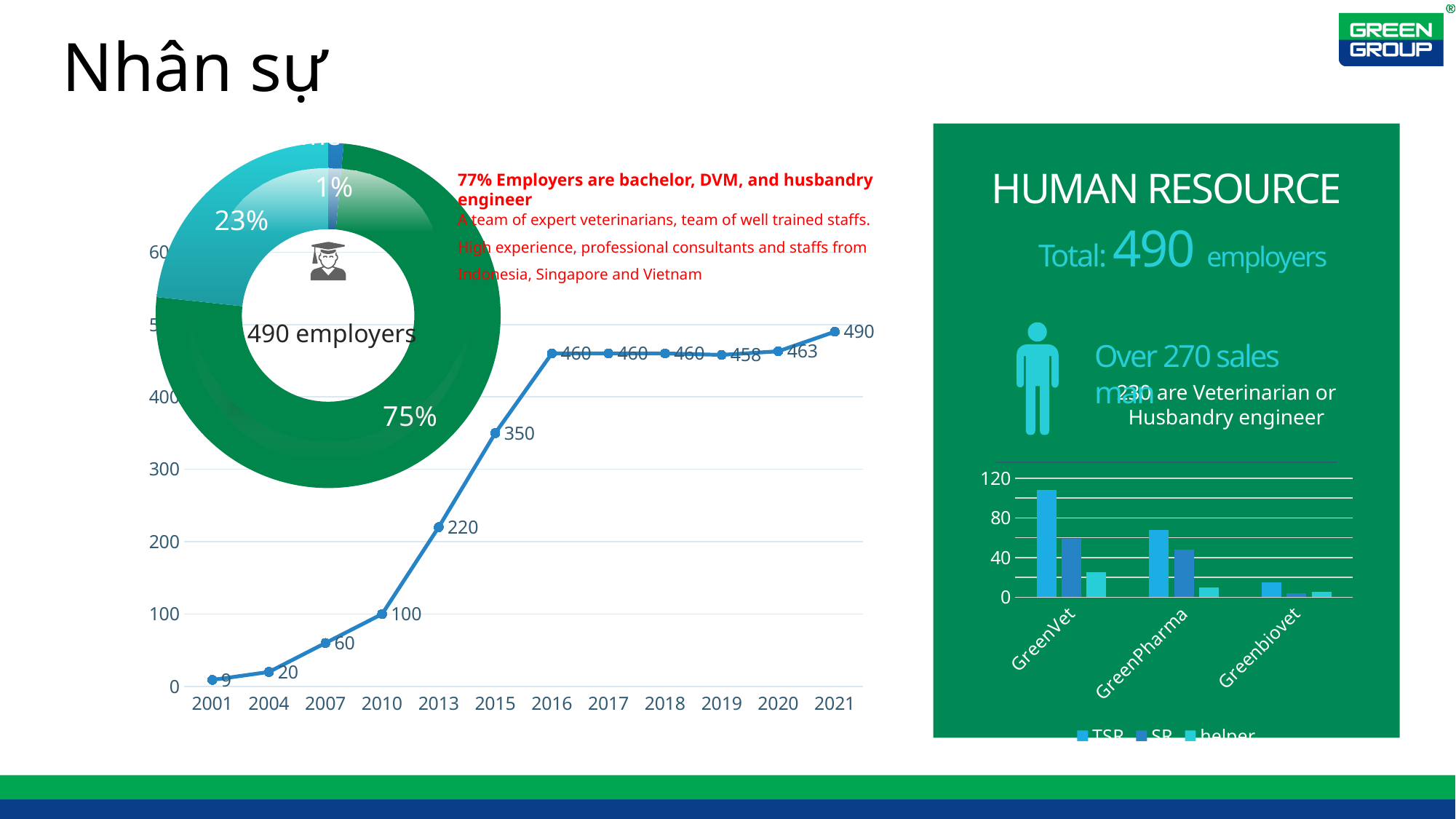
In the line chart, how many data points are plotted? 12 In the line chart, what value is shown for 2021? 490 In the donut chart, what percentage is shown for the largest (green) slice? 75% In the bar chart on the right, which company has the lowest TSR bar? Greenbiovet In the bar chart on the right, is the TSR value for GreenVet greater or less than 80? greater In the line chart, which year has the highest value? 2021 In the line chart, which year has the lowest value? 2001 In the bar chart on the right, how many series does the legend list? 3 In the donut chart, what text appears in the centre? 490 employers In the line chart, do the values generally rise or fall from 2001 to 2021? rise In the line chart, what is the difference between the values for 2015 and 2013? 130 In the line chart, what value is shown for 2013? 220